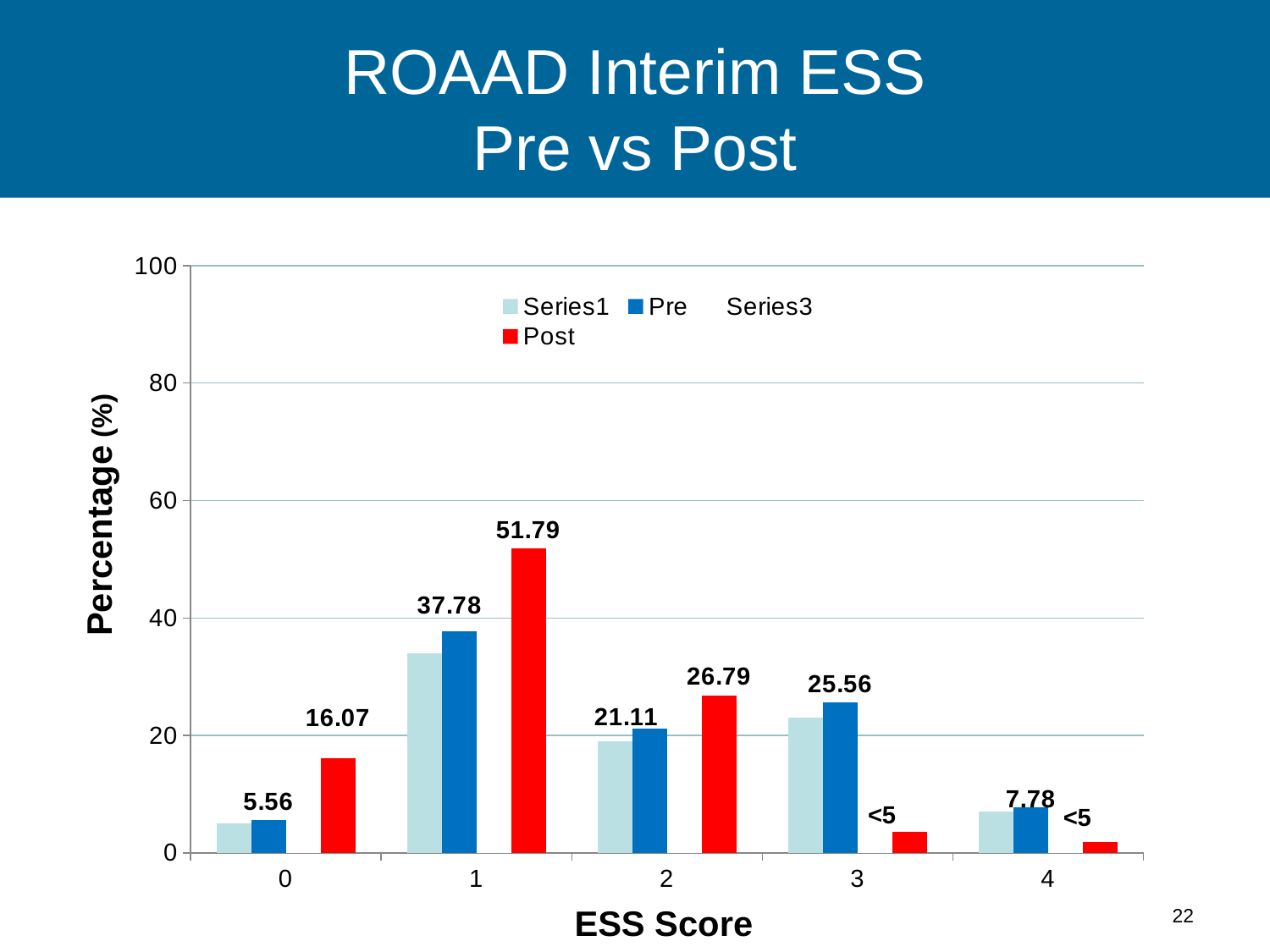
What is the Pre value for ESS Score 1? 37.78 What label is shown for the Post value at ESS Score 4? <5 What kind of chart is shown on the slide? Bar chart How many ESS Score categories are shown on the x axis? 5 Which ESS Score has the highest Post value? 1 Is the Post value for ESS Score 1 greater or less than 40? greater What is the Pre value for ESS Score 3? 25.56 Which ESS Score has the lowest Pre value? 0 What is the Post value for ESS Score 1? 51.79 At ESS Score 2, which is larger, the Pre value or the Post value? Post What is the difference between the Post and Pre values at ESS Score 1? 14.01 What is the Post value for ESS Score 0? 16.07